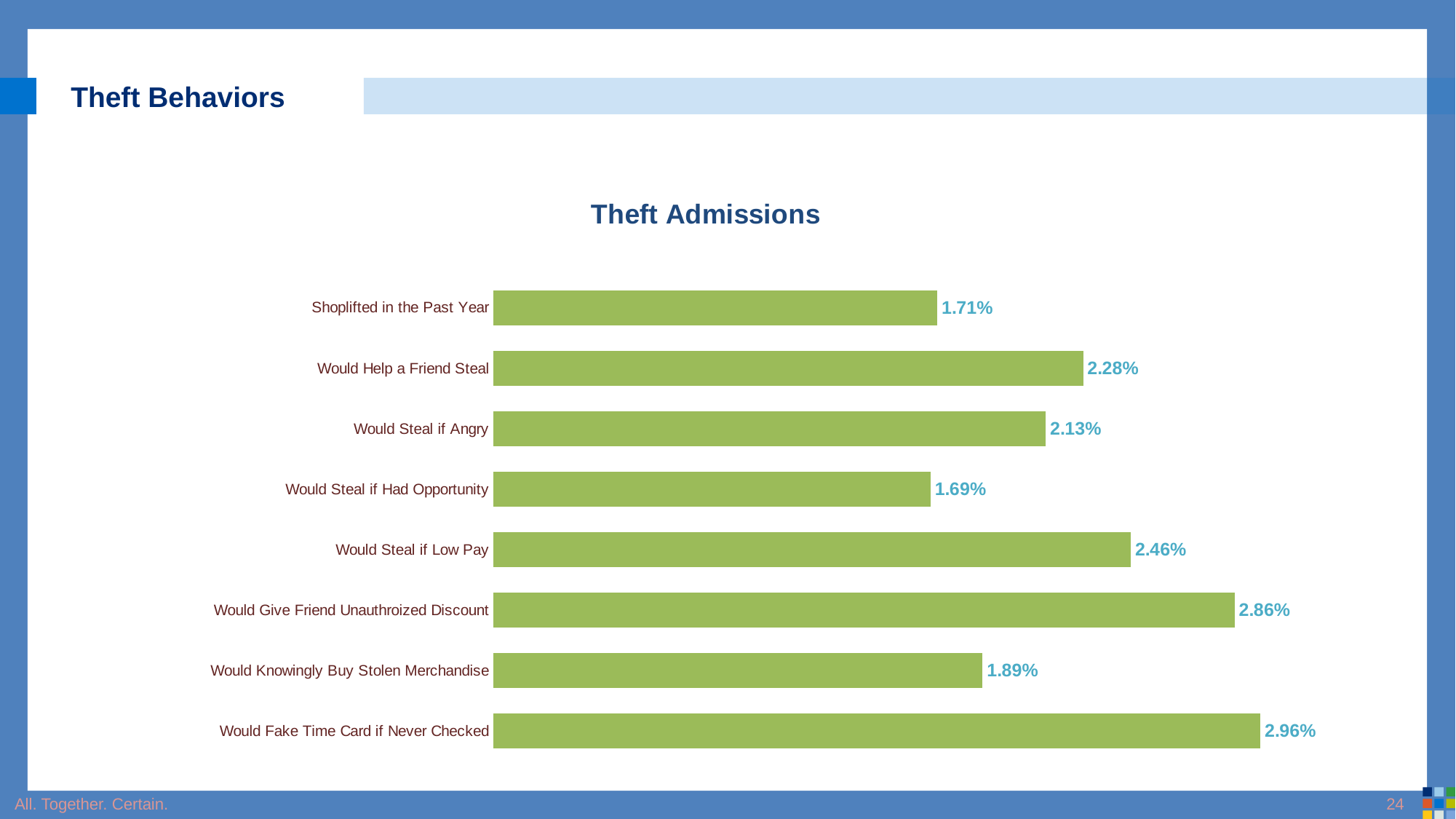
What kind of chart is this? Bar chart Which is larger, "Would Steal if Low Pay" or "Would Knowingly Buy Stolen Merchandise"? Would Steal if Low Pay What is the difference between "Would Give Friend Unauthroized Discount" and "Would Steal if Angry"? 0.73% What is the title of the chart? Theft Admissions Which category has the lowest value? Would Steal if Had Opportunity What is the value for "Would Steal if Low Pay"? 2.46% What is the value for "Would Knowingly Buy Stolen Merchandise"? 1.89% Which category has the highest value? Would Fake Time Card if Never Checked How many categories are shown in the chart? 8 What is the value for "Shoplifted in the Past Year"? 1.71% What is the difference between "Would Fake Time Card if Never Checked" and "Shoplifted in the Past Year"? 1.25% Which is larger, "Would Help a Friend Steal" or "Would Steal if Angry"? Would Help a Friend Steal